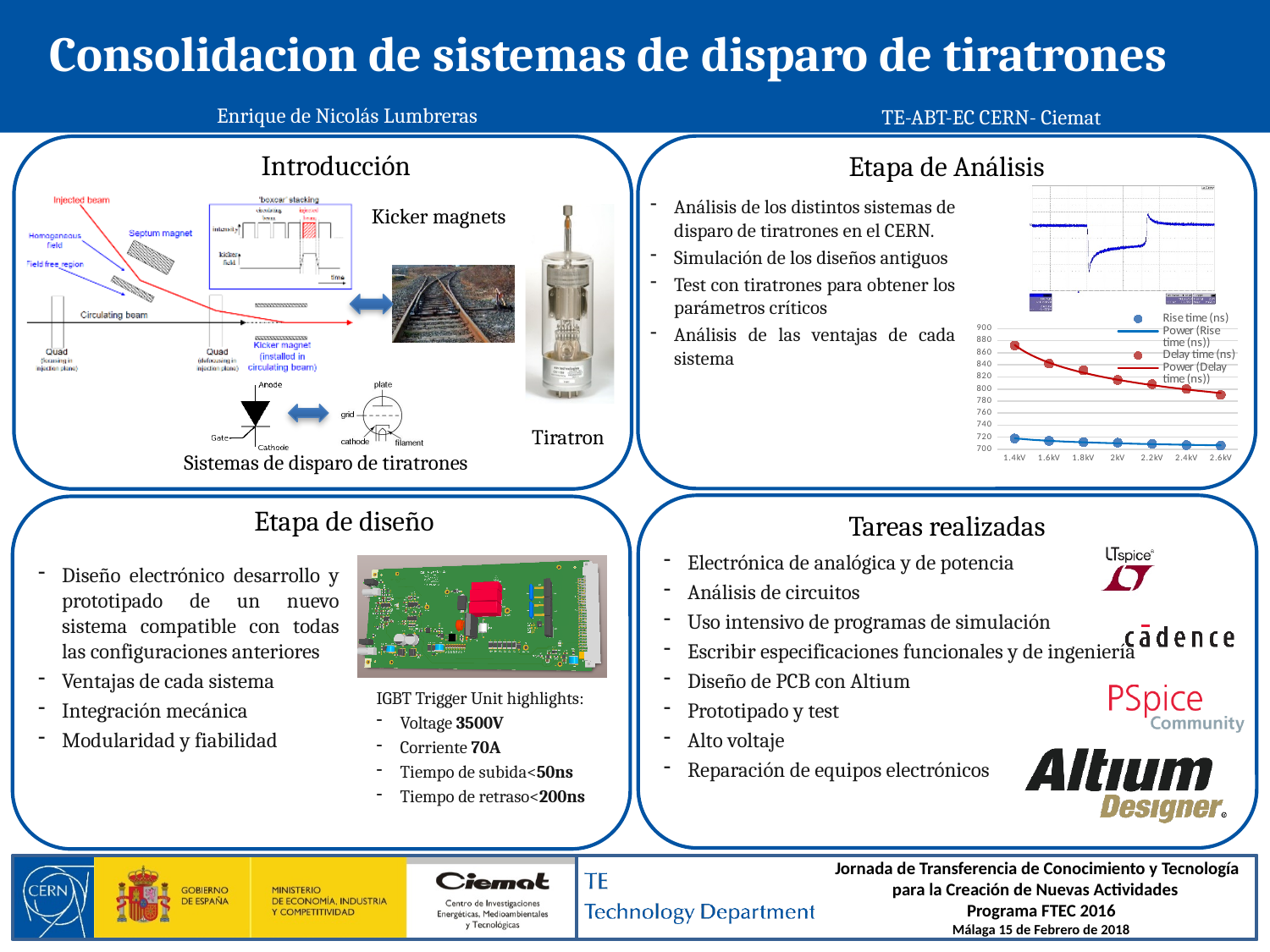
What is the highest value shown on the y axis of the chart in the Etapa de Análisis section? 900 In the chart in the Etapa de Análisis section, at which voltage is the Delay time (ns) value highest? 1.4kV How many voltage tick labels are shown on the x axis of the chart in the Etapa de Análisis section? 7 In the chart in the Etapa de Análisis section, does the Delay time (ns) series rise or fall as the voltage increases from 1.4kV to 2.6kV? fall In the chart in the Etapa de Análisis section, is the Delay time (ns) value at 2.6kV greater or less than 840? less In the chart in the Etapa de Análisis section, is the Delay time (ns) value at 1.4kV greater or less than 840? greater In the chart in the Etapa de Análisis section, at which voltage is the Delay time (ns) value lowest? 2.6kV How many entries does the legend of the chart in the Etapa de Análisis section list? 4 In the chart in the Etapa de Análisis section, which series has higher values, Rise time (ns) or Delay time (ns)? Delay time (ns) What is the lowest voltage label on the x axis of the chart in the Etapa de Análisis section? 1.4kV What kind of chart is shown in the Etapa de Análisis section? line chart In the chart in the Etapa de Análisis section, is the Rise time (ns) value at 2.6kV greater or less than 740? less